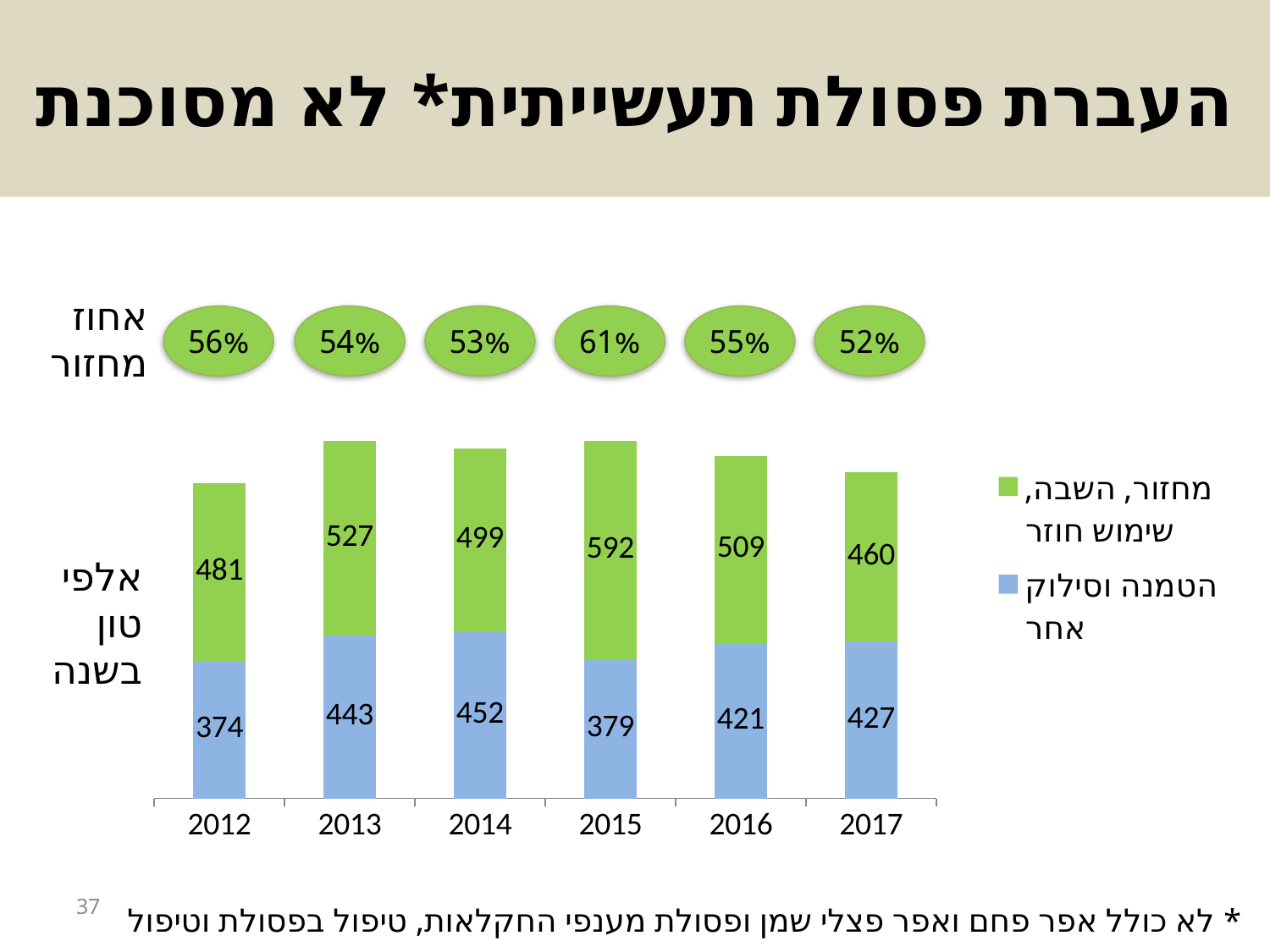
In which year is the blue series (הטמנה וסילוק אחר) lowest? 2012 In which year is the green series (מחזור, השבה, שימוש חוזר) highest? 2015 How many years are shown on the x axis of the chart? 6 How many series does the chart legend list? 2 What is the value of the green series (מחזור, השבה, שימוש חוזר) for 2015? 592 What recycling percentage (אחוז מחזור) is shown above the bar for 2017? 52% What type of chart is shown on the slide? stacked bar chart What is the value of the blue series (הטמנה וסילוק אחר) for 2014? 452 Which year has the highest recycling percentage (אחוז מחזור) shown in the ovals? 2015 What is the difference between the green series values for 2015 and 2017? 132 What is the total of the stacked bar for 2013? 970 Which is larger: the blue series value for 2016 or for 2015? 2016